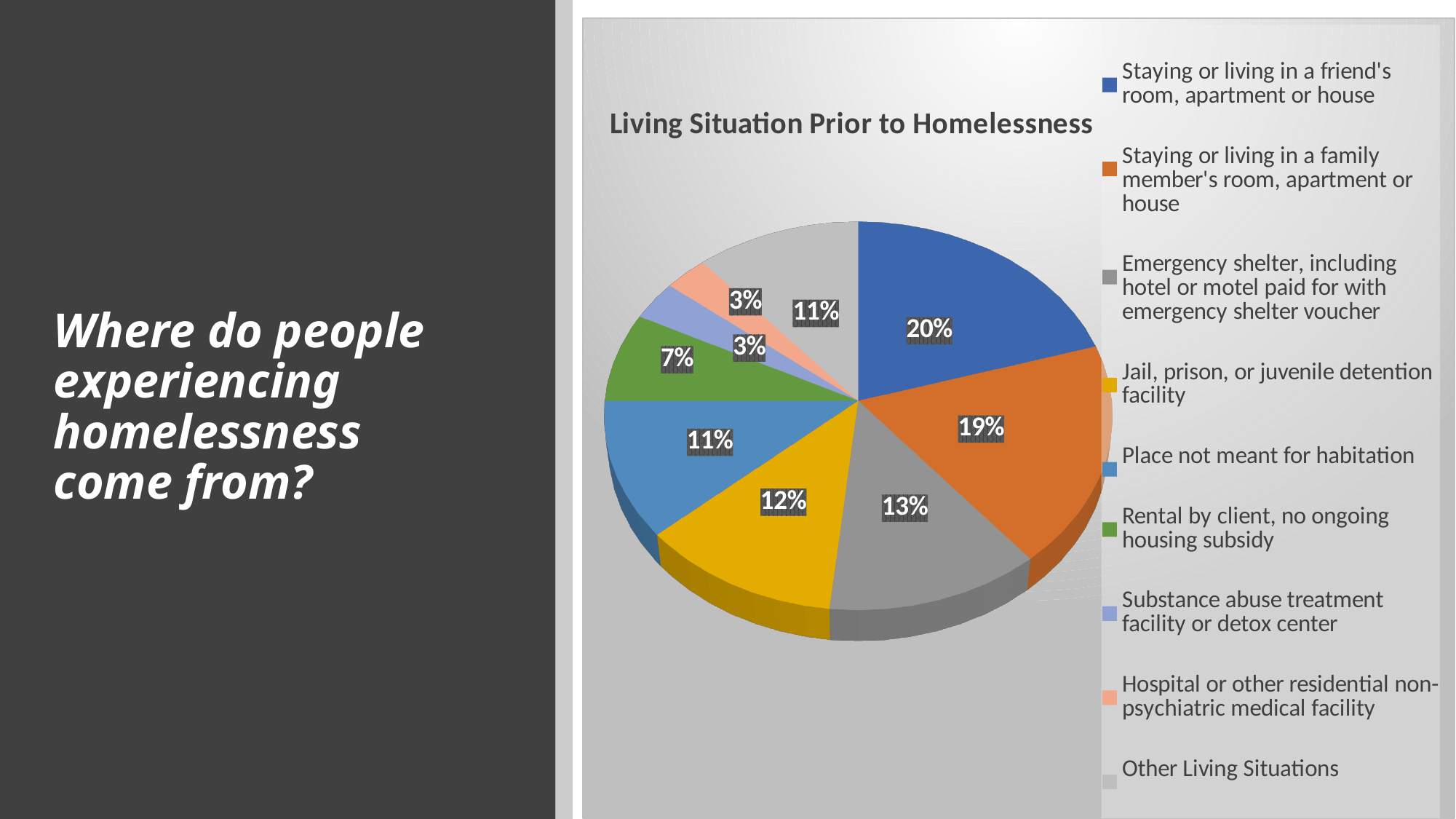
Which is larger: the share for jail, prison, or juvenile detention facility or the share for place not meant for habitation? Jail, prison, or juvenile detention facility Which living situation has the largest share of the pie? Staying or living in a friend's room, apartment or house What is the title of the chart? Living Situation Prior to Homelessness What percentage is shown for rental by client, no ongoing housing subsidy? 7% What percentage is shown for substance abuse treatment facility or detox center? 3% What percentage of people were staying or living in a friend's room, apartment or house prior to homelessness? 20% What percentage is shown for jail, prison, or juvenile detention facility? 12% What is the difference in percentage points between emergency shelter (13%) and rental by client, no ongoing housing subsidy (7%)? 6 What share of the pie is for staying or living in a family member's room, apartment or house? 19% How many categories does the legend list? 9 What kind of chart is shown on the slide? Pie chart What percentage is shown for emergency shelter, including hotel or motel paid for with emergency shelter voucher? 13%